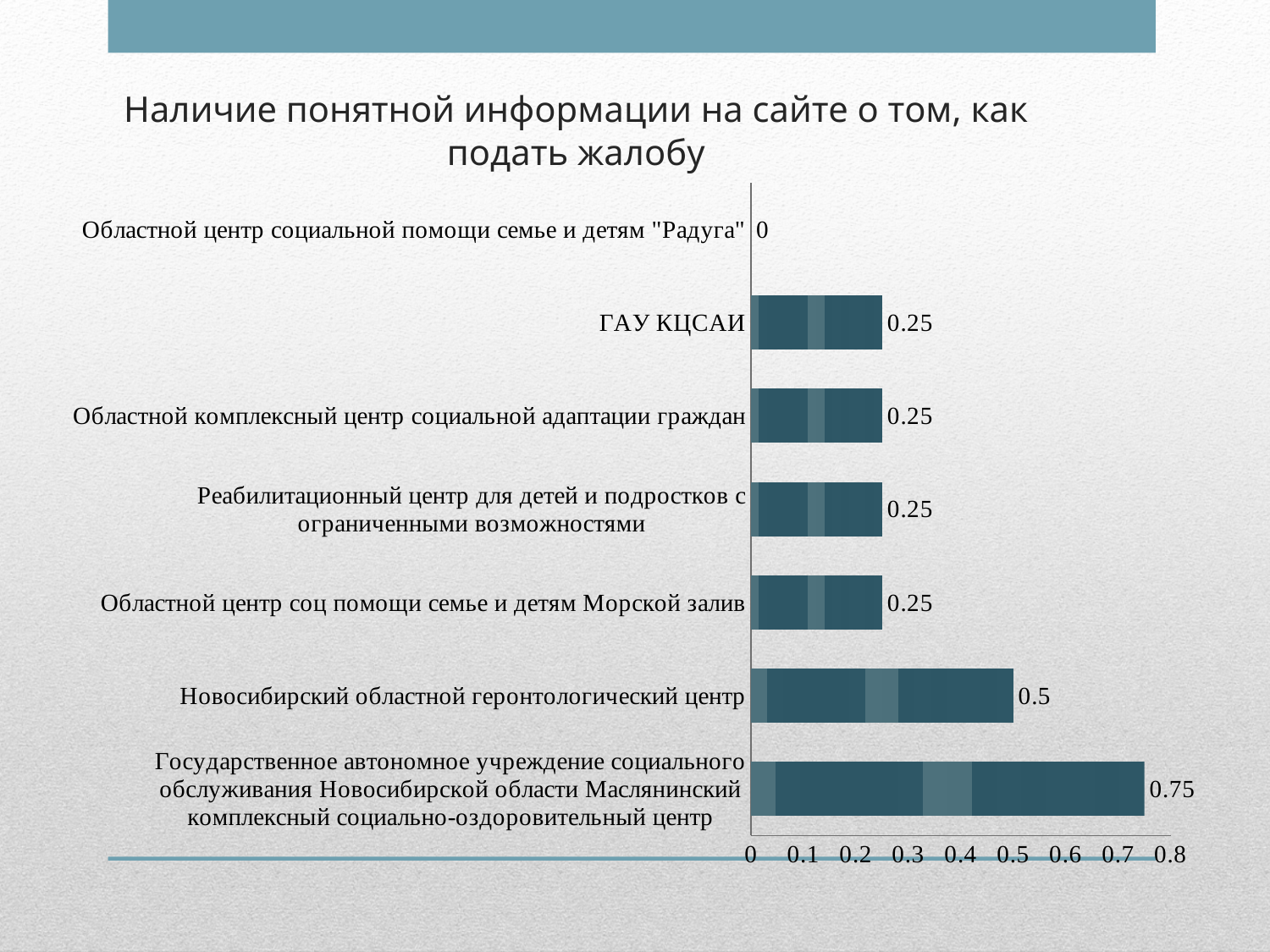
Which category has the highest value? Государственное автономное учреждение социального обслуживания Новосибирской области Маслянинский комплексный социально-оздоровительный центр What is the difference between the value for Маслянинский комплексный социально-оздоровительный центр and the value for Новосибирский областной геронтологический центр? 0.25 What kind of chart is shown on the slide? bar chart What value is shown for Областной центр социальной помощи семье и детям "Радуга"? 0 Is the value for Новосибирский областной геронтологический центр greater or less than 0.3? greater How many categories are shown in the chart? 7 What is the title of the chart? Наличие понятной информации на сайте о том, как подать жалобу What value is shown for Государственное автономное учреждение социального обслуживания Новосибирской области Маслянинский комплексный социально-оздоровительный центр? 0.75 Which category has the lowest value? Областной центр социальной помощи семье и детям "Радуга" What value is shown for ГАУ КЦСАИ? 0.25 Which is larger: the value for Новосибирский областной геронтологический центр or the value for ГАУ КЦСАИ? Новосибирский областной геронтологический центр What value is shown for Новосибирский областной геронтологический центр? 0.5